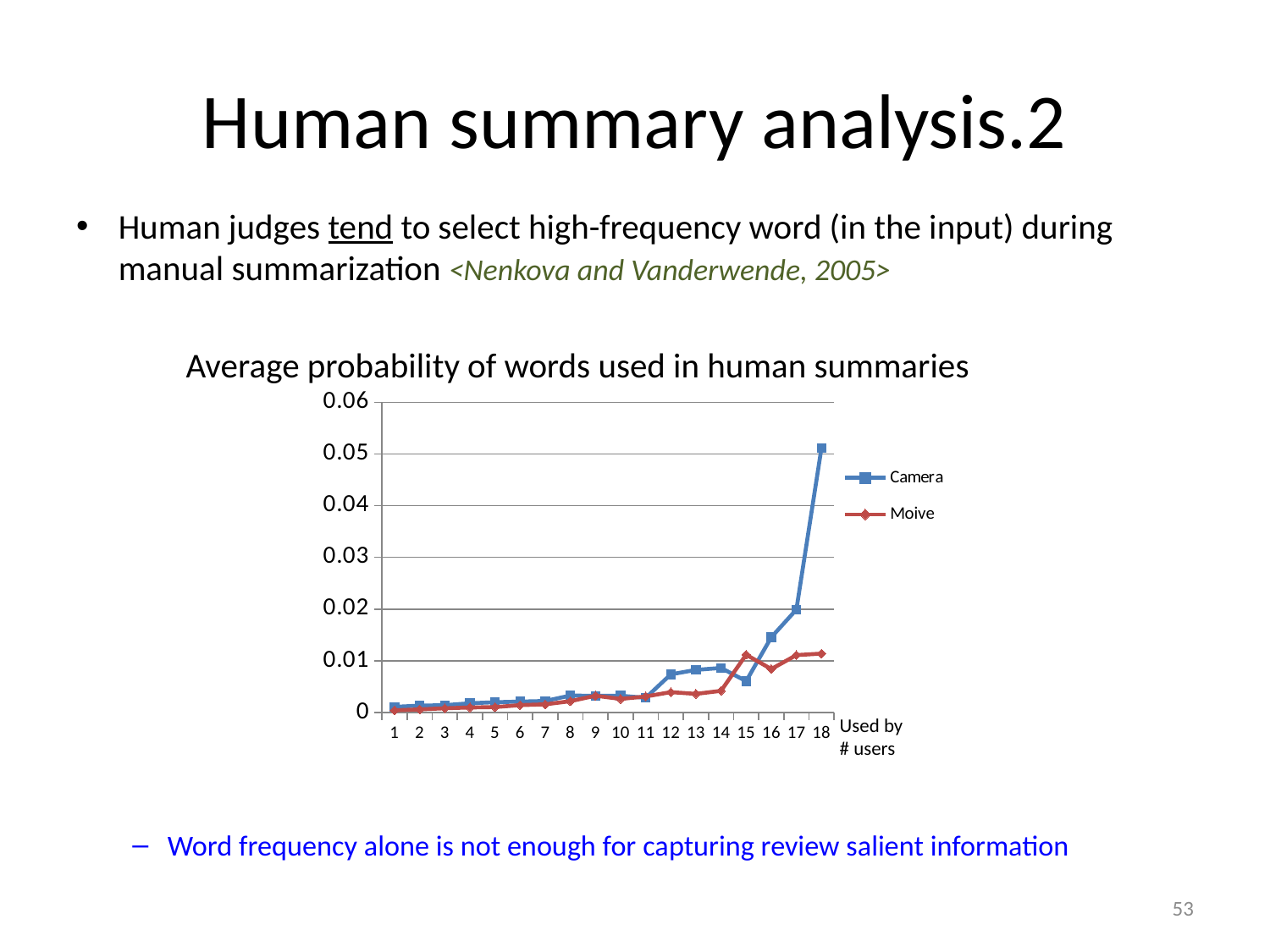
Does the Camera series generally rise or fall as the x axis increases from 1 to 18? rise What are the two series named in the legend? Camera and Moive How many points are plotted along the x axis for each series? 18 Is the Camera value at x = 12 greater or less than 0.01? less How many series does the legend list? 2 At x = 18, which series has the larger value, Camera or Moive? Camera Which series reaches the highest value on the chart? Camera Is the Moive value at x = 18 greater or less than 0.02? less Is the Camera value at x = 16 greater or less than 0.01? greater What kind of chart is shown on the slide? line chart What is the title of the chart? Average probability of words used in human summaries